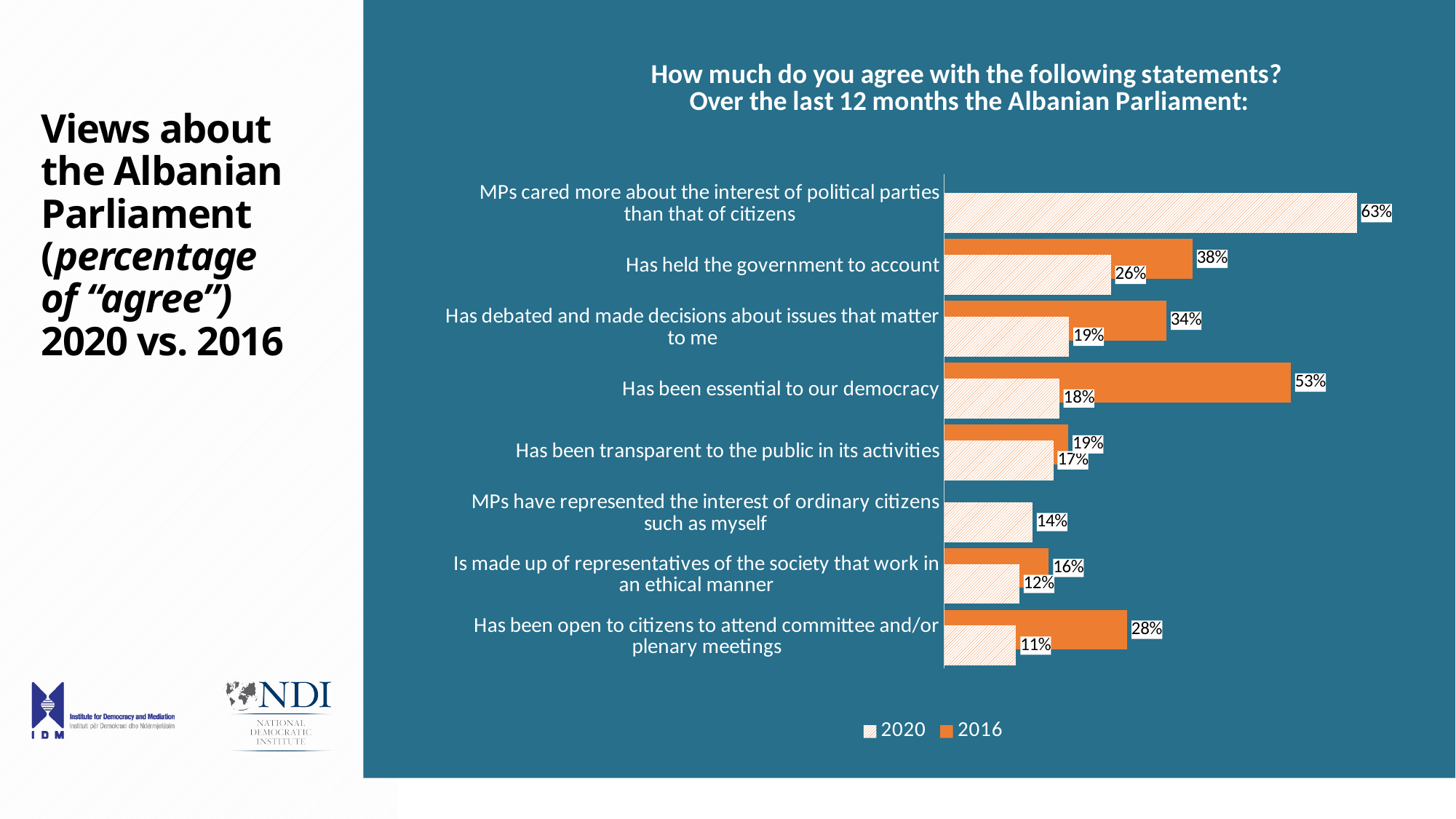
What percentage agreed in 2020 that MPs cared more about the interest of political parties than that of citizens? 63% What is the difference between the 2016 and 2020 values for "Has been essential to our democracy"? 35 percentage points What was the 2020 value for "Has held the government to account"? 26% What type of chart is shown on the slide? Bar chart How many series does the legend list? 2 For "Is made up of representatives of the society that work in an ethical manner", which year has the larger value, 2016 or 2020? 2016 How many statements are listed on the chart? 8 What was the 2016 value for "Has been essential to our democracy"? 53% What is the difference between the 2016 and 2020 values for "Has debated and made decisions about issues that matter to me"? 15 percentage points What was the 2016 value for "Has been open to citizens to attend committee and/or plenary meetings"? 28% Which statement has the highest 2016 value? Has been essential to our democracy Which statement has the lowest 2020 value? Has been open to citizens to attend committee and/or plenary meetings